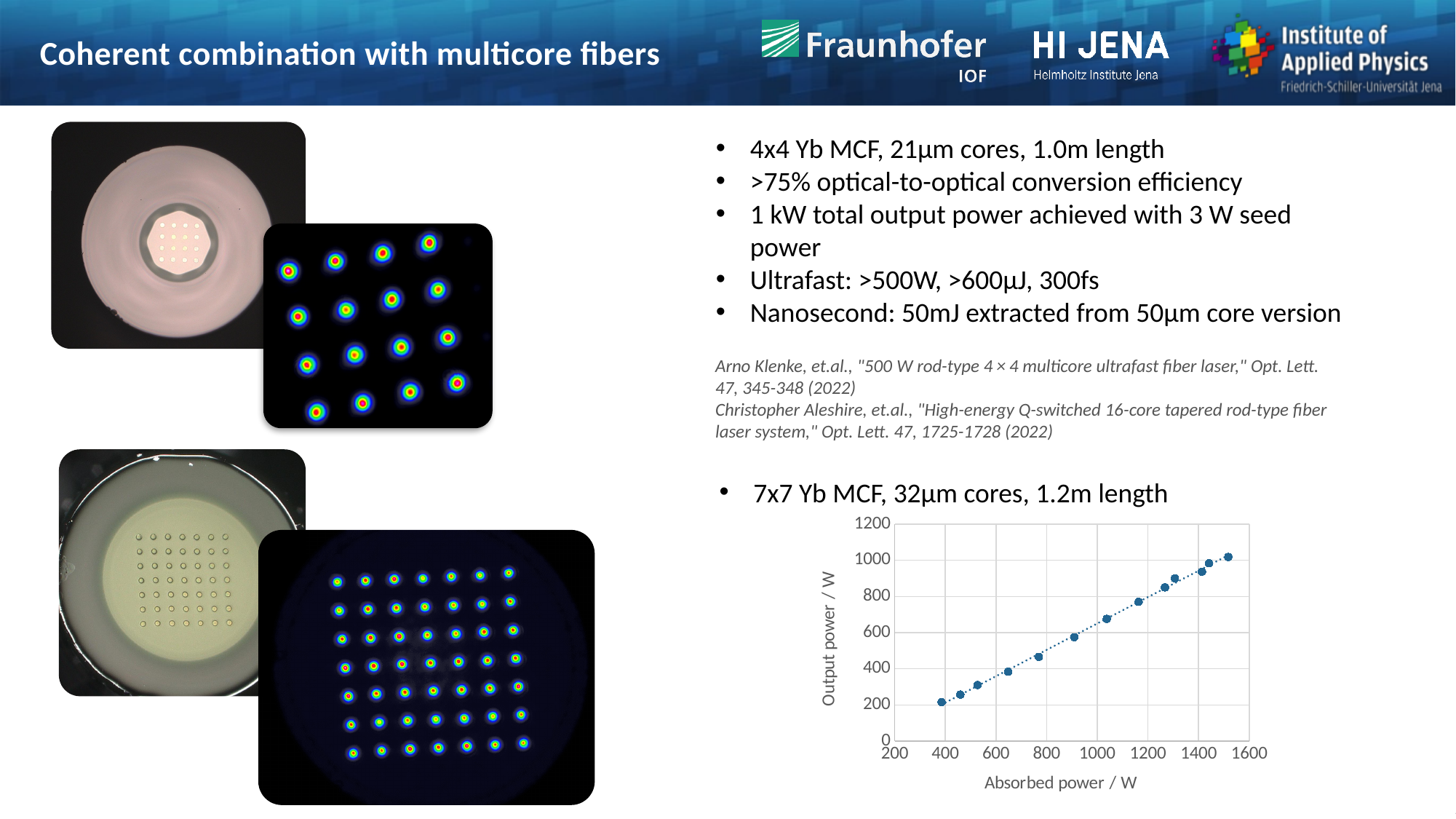
Is the lowest absorbed power plotted on the chart greater or less than 200 W? greater Does the output power rise or fall as the absorbed power increases along the x axis? rise Is the output power at roughly 1040 W absorbed power greater or less than 600 W? greater Is the lowest output power plotted on the chart greater or less than 400 W? less What is the label of the x axis of the chart? Absorbed power / W What kind of chart is shown on the slide? scatter chart What is the label of the y axis of the chart? Output power / W Which has the higher output power: the point at roughly 900 W absorbed power or the point at roughly 1300 W absorbed power? the point at roughly 1300 W absorbed power